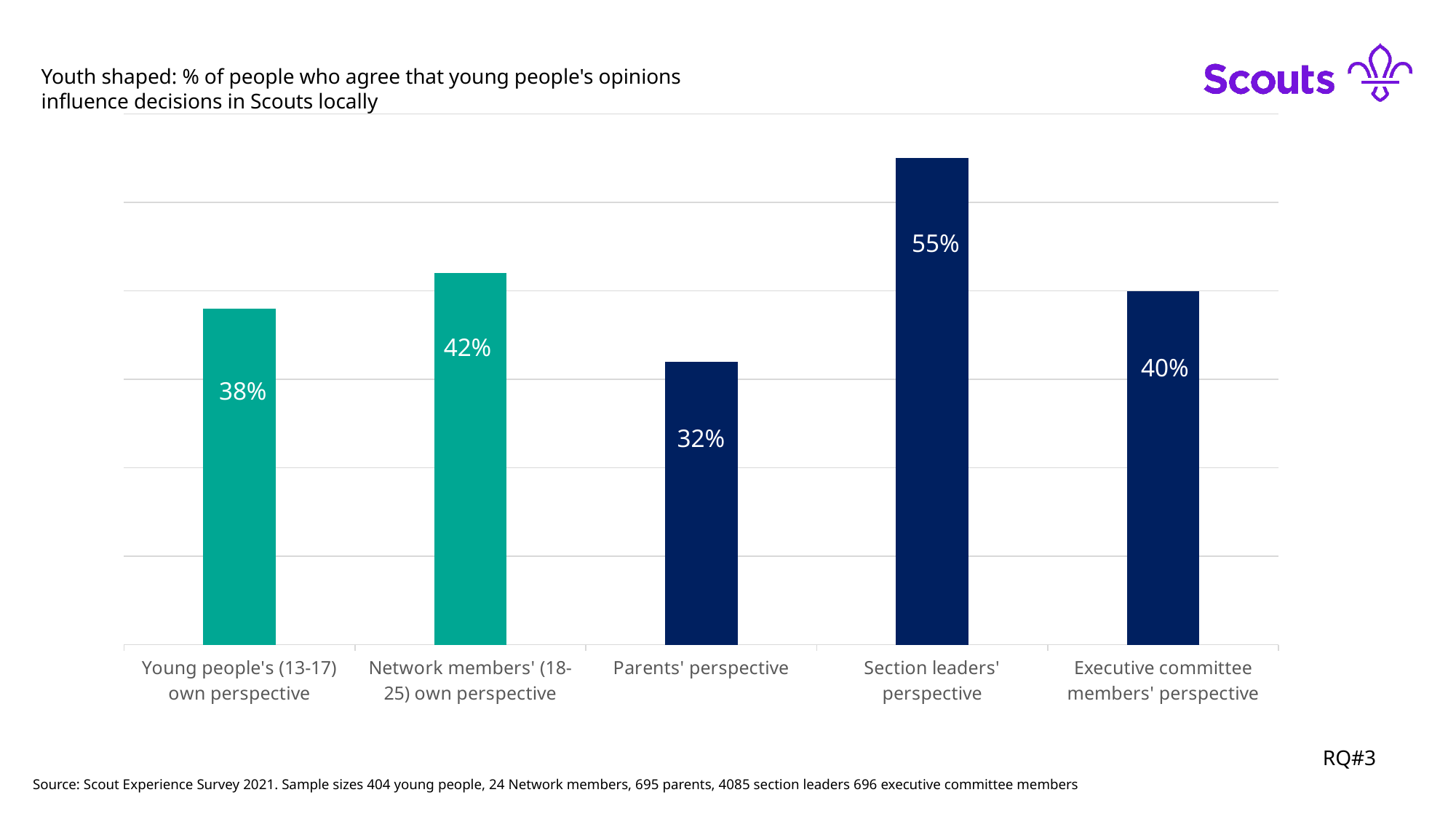
Which perspective has the highest percentage agreeing? Section leaders' perspective What is the difference between Section leaders' perspective and Parents' perspective? 23% Which is larger: the value for Executive committee members' perspective or Young people's (13-17) own perspective? Executive committee members' perspective What is the value for Network members' (18-25) own perspective? 42% How many categories are shown on the chart? 5 What is the value for Parents' perspective? 32% What is the value for Executive committee members' perspective? 40% What percentage of young people (13-17) agree that young people's opinions influence decisions in Scouts locally? 38% Which perspective has the lowest percentage agreeing? Parents' perspective Which survey is cited as the source of the chart data? Scout Experience Survey 2021 What is the difference between Network members' (18-25) own perspective and Young people's (13-17) own perspective? 4% What kind of chart is shown on the slide? Bar chart